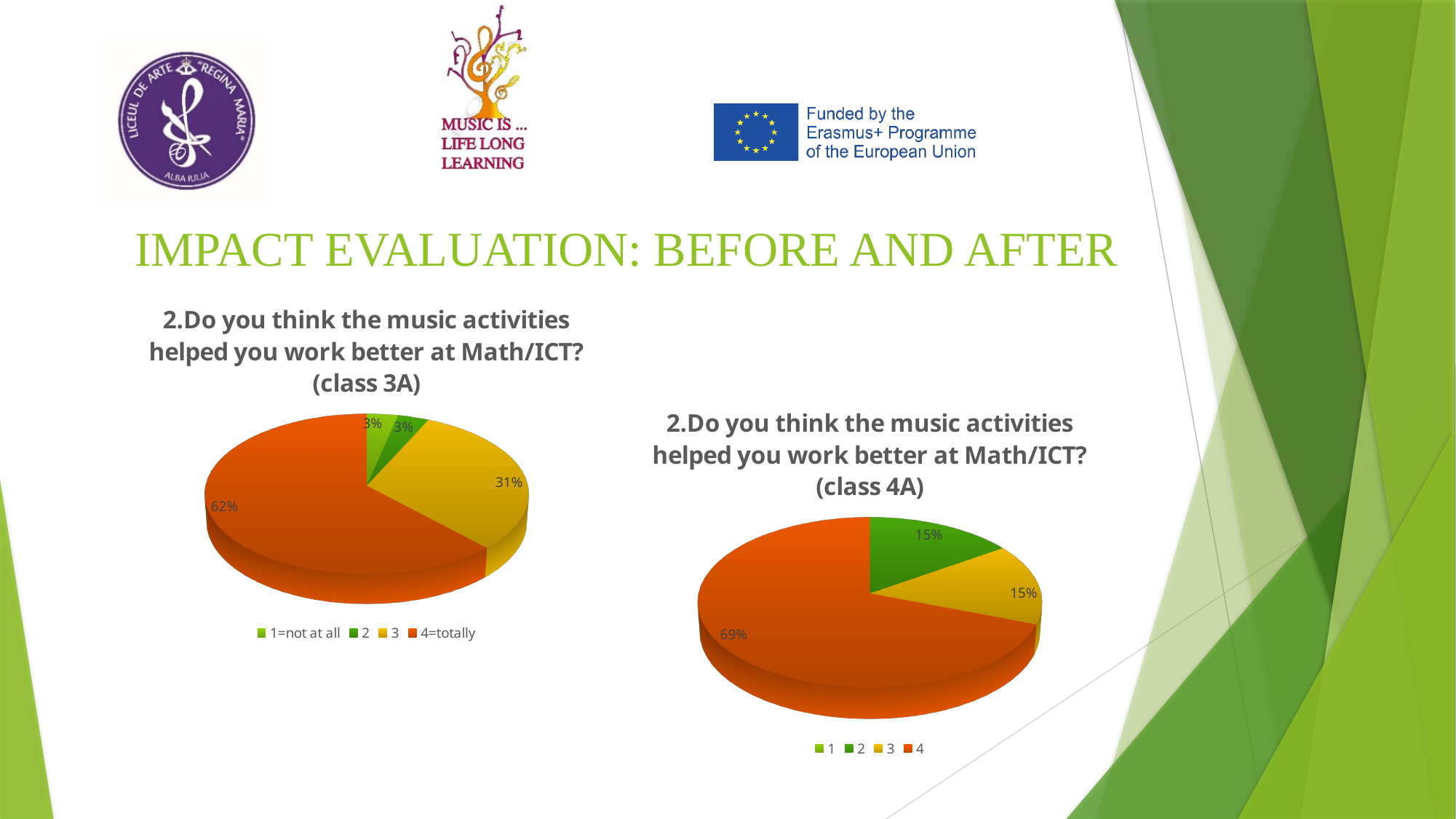
In the class 4A chart, which category has the largest slice? 4 In the class 4A chart, what share of responses is category 4? 69% In the class 3A chart, which category has the largest slice? 4=totally Which is larger: the category 4 share in the class 4A chart or the '4=totally' share in the class 3A chart? Class 4A (69%) In the class 3A chart, what share of responses is '1=not at all'? 3% How many entries does the legend of the class 4A chart list? 4 In the class 3A chart, what is the difference between the '4=totally' share and the category 3 share? 31% In the class 4A chart, what share of responses is category 3? 15% In the class 3A chart, what colour is the '4=totally' slice? Orange In the class 3A chart, what share of responses is '4=totally'? 62% In the class 3A chart, what share of responses is category 3? 31% What type of chart is used for the class 3A data? Pie chart